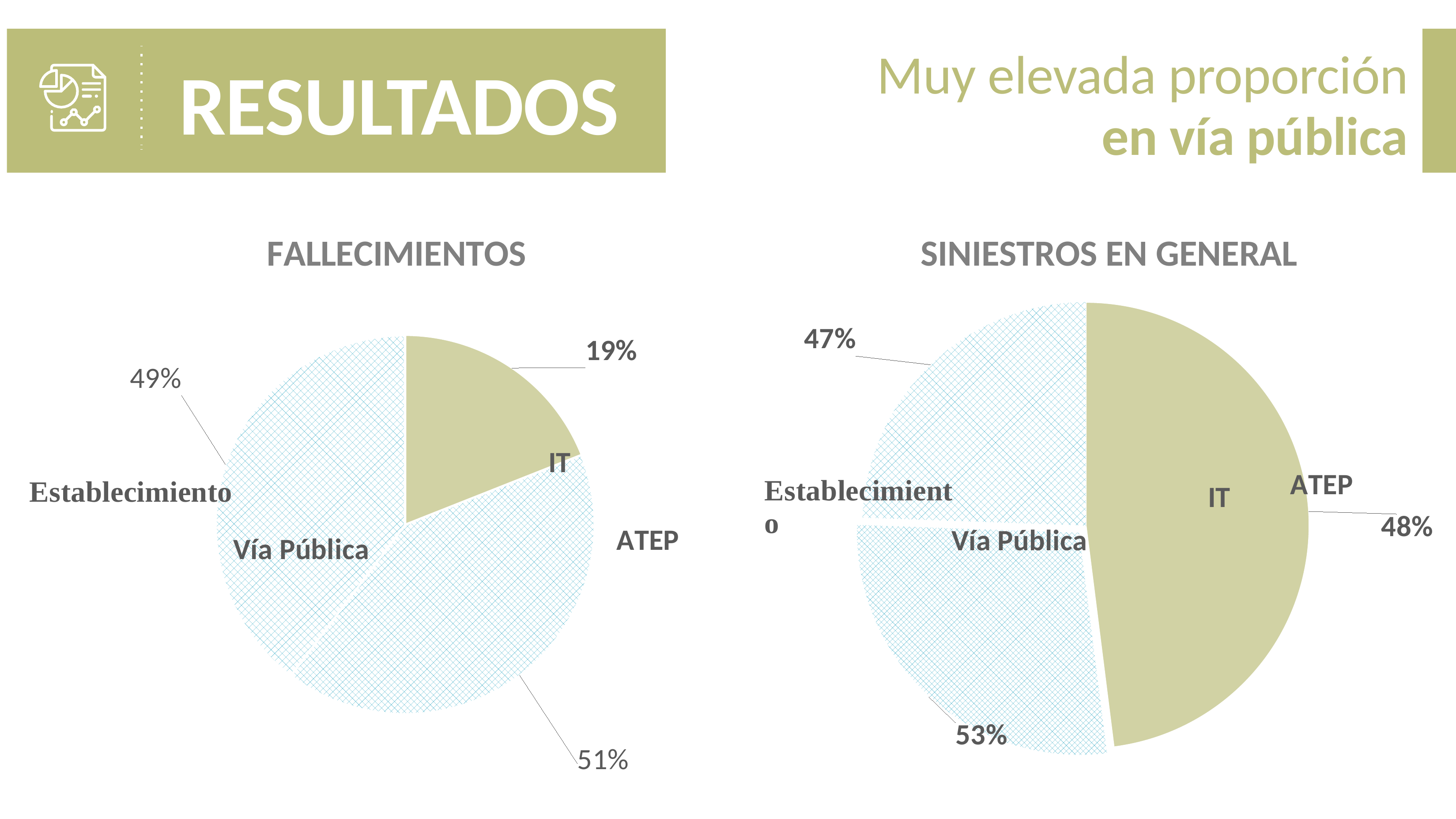
Which chart shows a larger percentage for the IT / ATEP slice, FALLECIMIENTOS or SINIESTROS EN GENERAL? SINIESTROS EN GENERAL In the SINIESTROS EN GENERAL chart, what percentage label is attached to the Establecimiento slice? 47% In the FALLECIMIENTOS chart, which slice is the smallest? IT / ATEP In the FALLECIMIENTOS chart, what percentage is shown for the IT / ATEP slice? 19% In the FALLECIMIENTOS chart, what percentage label is attached to the Establecimiento slice? 49% In the SINIESTROS EN GENERAL chart, what percentage label is attached to the Vía Pública slice? 53% In the FALLECIMIENTOS chart, what percentage label is attached to the Vía Pública slice? 51% In the SINIESTROS EN GENERAL chart, which is larger, the Vía Pública label or the Establecimiento label? Vía Pública What kind of chart is the FALLECIMIENTOS chart? Pie chart How many slices does the SINIESTROS EN GENERAL pie chart have? 3 In the FALLECIMIENTOS chart, what is the difference between the Vía Pública label and the Establecimiento label? 2 percentage points In the SINIESTROS EN GENERAL chart, what percentage is shown for the IT / ATEP slice? 48%